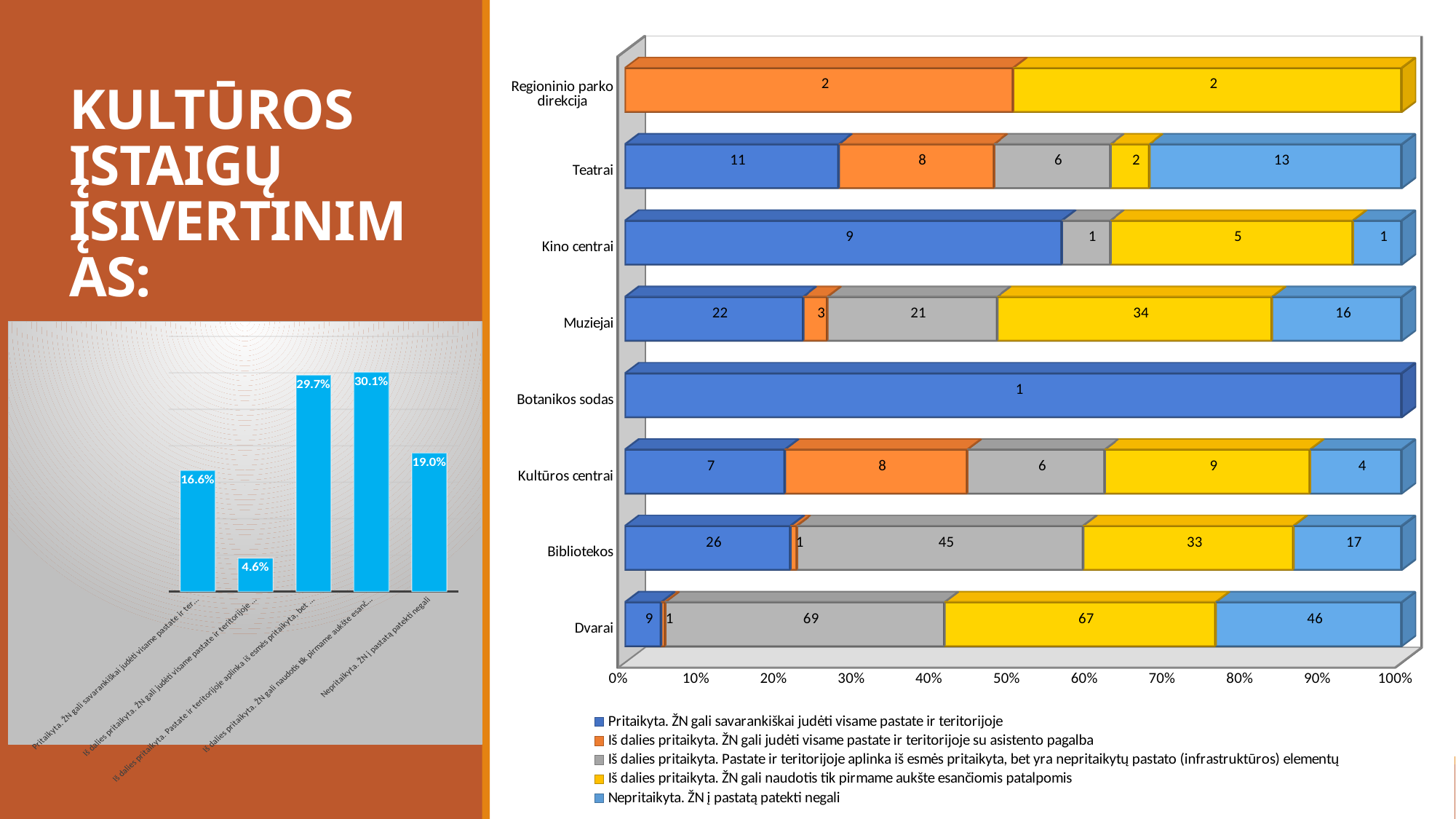
In the large stacked bar chart on the right, what is the value for Muziejai in the series "Iš dalies pritaikyta. ŽN gali naudotis tik pirmame aukšte esančiomis patalpomis"? 34 In the large stacked bar chart on the right, how many categories are shown on the vertical axis? 8 In the large stacked bar chart on the right, what is the total of all segments for Dvarai? 192 In the large stacked bar chart on the right, how many series does the legend list? 5 In the large stacked bar chart on the right, what is the value for Kino centrai in the series "Pritaikyta. ŽN gali savarankiškai judėti visame pastate ir teritorijoje"? 9 In the small bar chart on the left, what is the highest value shown? 30.1% What kind of chart is the large chart on the right? Stacked bar chart In the large stacked bar chart on the right, what is the total of all segments for Teatrai? 40 In the small bar chart on the left, what is the value for "Nepritaikyta. ŽN į pastatą patekti negali"? 19.0% In the large stacked bar chart on the right, what is the difference between the two largest segments for Dvarai (69 and 67)? 2 In the large stacked bar chart on the right, what is the value for Dvarai in the series "Nepritaikyta. ŽN į pastatą patekti negali"? 46 In the large stacked bar chart on the right, what is the value for Bibliotekos in the series "Iš dalies pritaikyta. Pastate ir teritorijoje aplinka iš esmės pritaikyta, bet yra nepritaikytų pastato (infrastruktūros) elementų"? 45